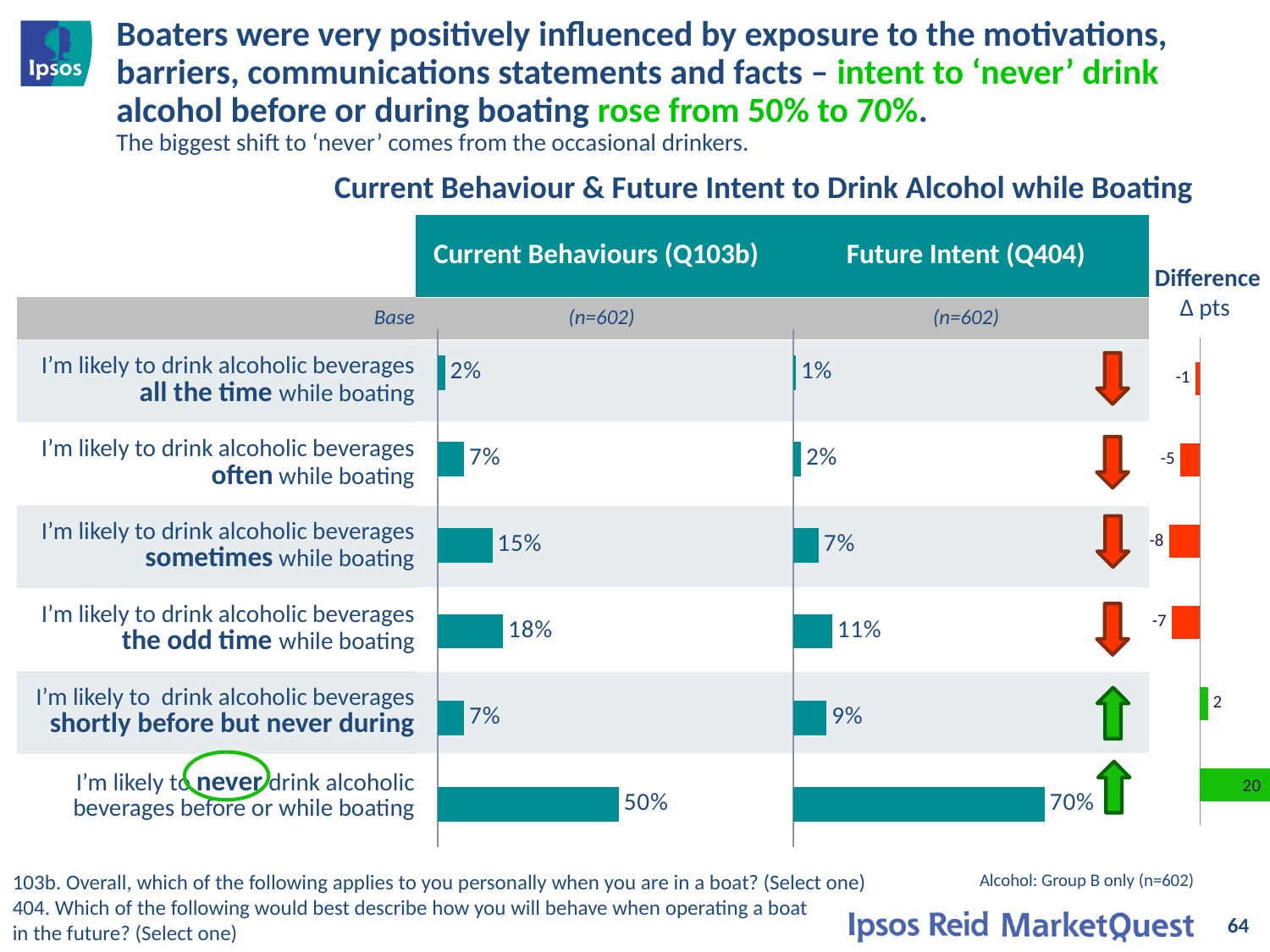
How many categories are shown in the Current Behaviours (Q103b) chart? 6 In the Current Behaviours (Q103b) chart, what is the value for 'I'm likely to drink alcoholic beverages sometimes while boating'? 15% What is the difference between the Future Intent (Q404) and Current Behaviours (Q103b) values for 'I'm likely to never drink alcoholic beverages before or while boating'? 20 percentage points In the Difference (Δ pts) chart, how many categories show a positive difference? 2 In the Current Behaviours (Q103b) chart, which is larger: the value for 'often while boating' or the value for 'the odd time while boating'? the odd time while boating What kind of chart is the Future Intent (Q404) chart? Bar chart In the Difference (Δ pts) chart, what is the value for 'I'm likely to drink alcoholic beverages sometimes while boating'? -8 In the Future Intent (Q404) chart, what is the value for 'I'm likely to drink alcoholic beverages the odd time while boating'? 11% What is the title shown above the charts? Current Behaviour & Future Intent to Drink Alcohol while Boating In the Future Intent (Q404) chart, which category has the lowest value? I'm likely to drink alcoholic beverages all the time while boating In the Current Behaviours (Q103b) chart, which category has the highest value? I'm likely to never drink alcoholic beverages before or while boating In the Future Intent (Q404) chart, what is the value for 'I'm likely to never drink alcoholic beverages before or while boating'? 70%